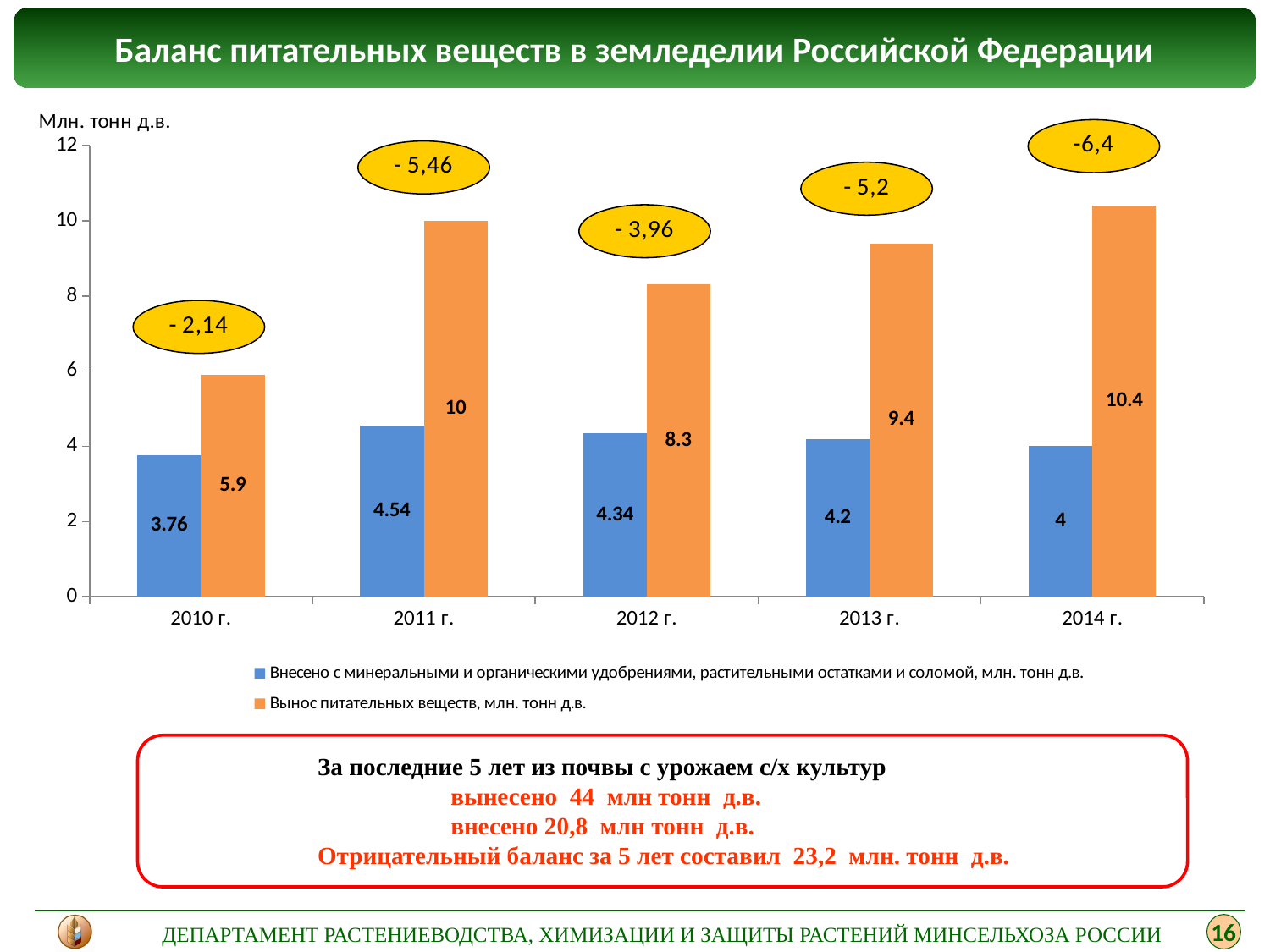
In which year is the orange series (Вынос питательных веществ) highest? 2014 г. What is the value of the orange series (Вынос питательных веществ) for 2011 г.? 10 What is the value of the blue series (Внесено...) for 2014 г.? 4 Is the value of the orange series for 2010 г. greater or less than 6? less In which year is the blue series (Внесено...) lowest? 2010 г. What is the difference between the orange and blue bars for 2012 г.? 3.96 What value is shown in the yellow oval above the 2013 г. bars? - 5,2 What kind of chart is shown on the slide? bar chart How many series does the legend list? 2 How many years are shown on the x axis? 5 Which is larger in 2013 г.: the blue bar (Внесено...) or the orange bar (Вынос питательных веществ)? the orange bar (Вынос питательных веществ) What is the value of the blue series (Внесено с минеральными и органическими удобрениями...) for 2010 г.? 3.76